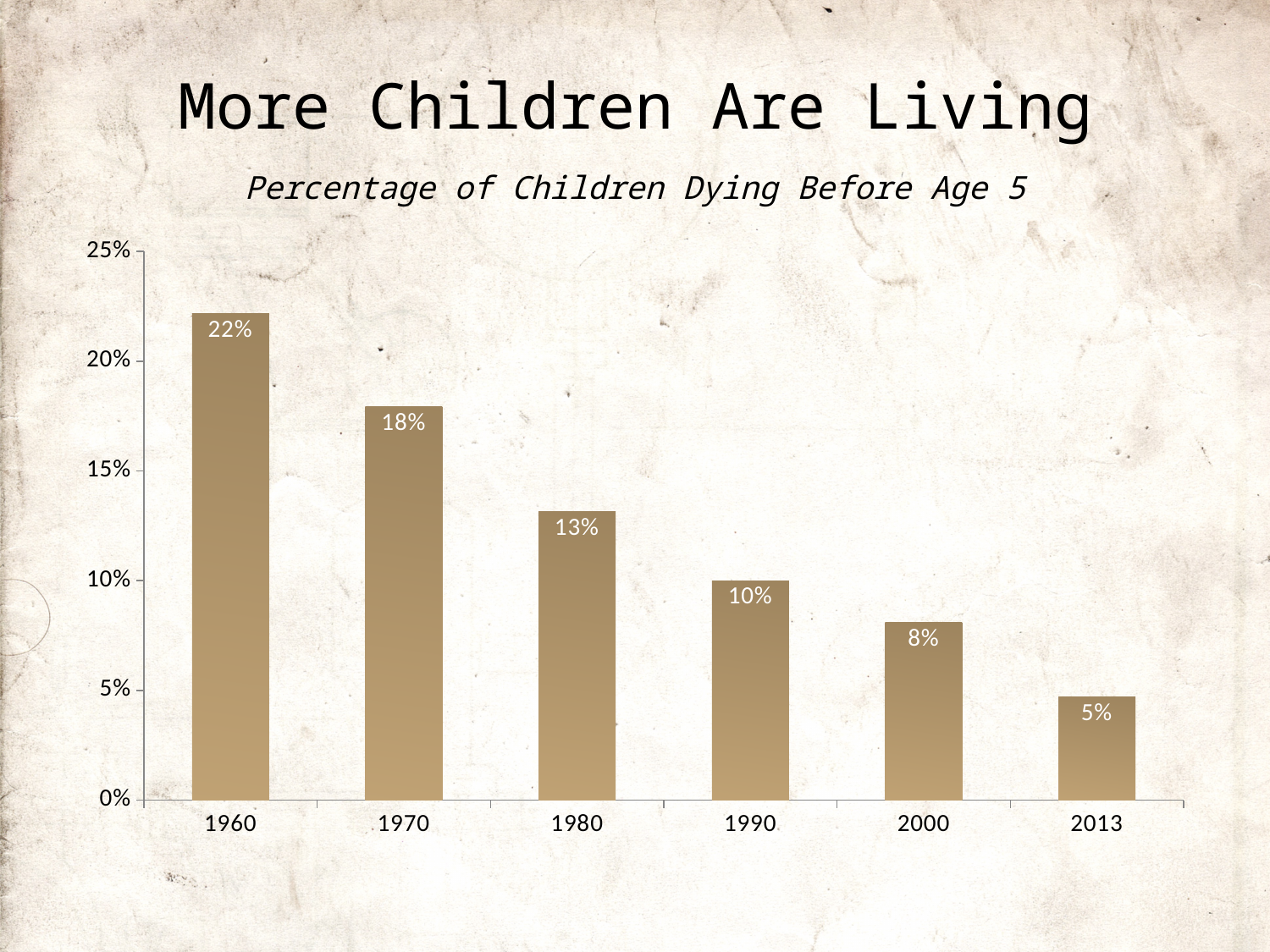
What is the percentage of children dying before age 5 in 1960? 22% What is the difference between the percentage in 1970 and the percentage in 1980? 5% Is the value for 1970 greater or less than 15%? greater What kind of chart is shown on the slide? Bar chart What is the difference between the percentage in 1960 and the percentage in 2013? 17% Which year has the lowest percentage of children dying before age 5? 2013 How many years are shown on the x axis of the chart? 6 What is the percentage of children dying before age 5 in 1990? 10% Which year has the highest percentage of children dying before age 5? 1960 Do the values rise or fall from 1960 to 2013? Fall Which is larger, the percentage for 1980 or the percentage for 2000? 1980 What is the percentage of children dying before age 5 in 2013? 5%